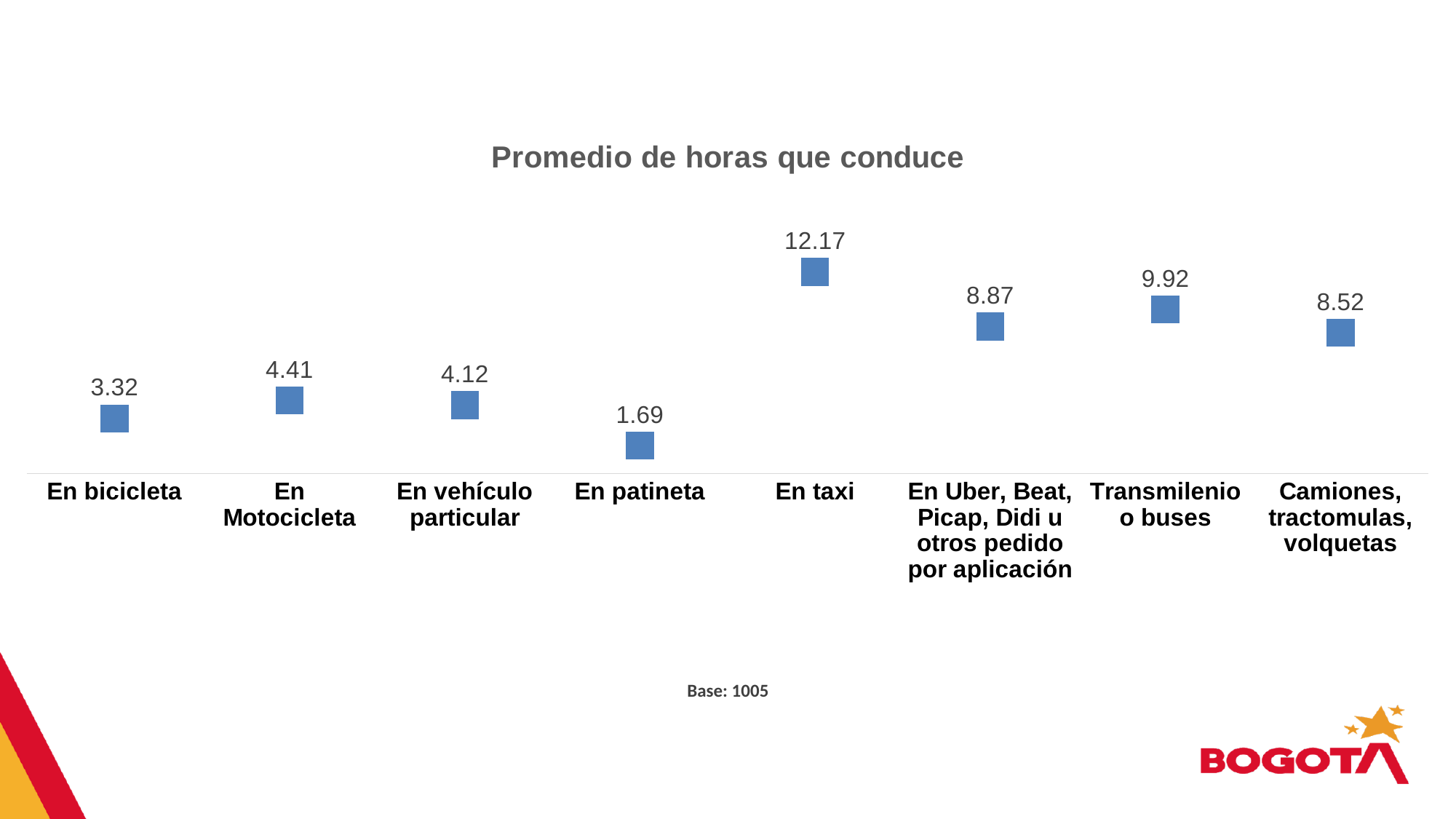
What is the value shown for 'En patineta'? 1.69 Which is larger, the value for 'Transmilenio o buses' or the value for 'En Uber, Beat, Picap, Didi u otros pedido por aplicación'? Transmilenio o buses What is the difference between the values for 'En Motocicleta' and 'En vehículo particular'? 0.29 What is the average number of hours driven 'En taxi'? 12.17 How many categories are plotted on the chart? 8 What is the value shown for 'En bicicleta'? 3.32 Which category has the lowest average hours driven? En patineta What is the value shown for 'Camiones, tractomulas, volquetas'? 8.52 Which category has the highest average hours driven? En taxi What is the title of the chart? Promedio de horas que conduce What is the difference between the values for 'En taxi' and 'En patineta'? 10.48 What is the value shown for 'Transmilenio o buses'? 9.92